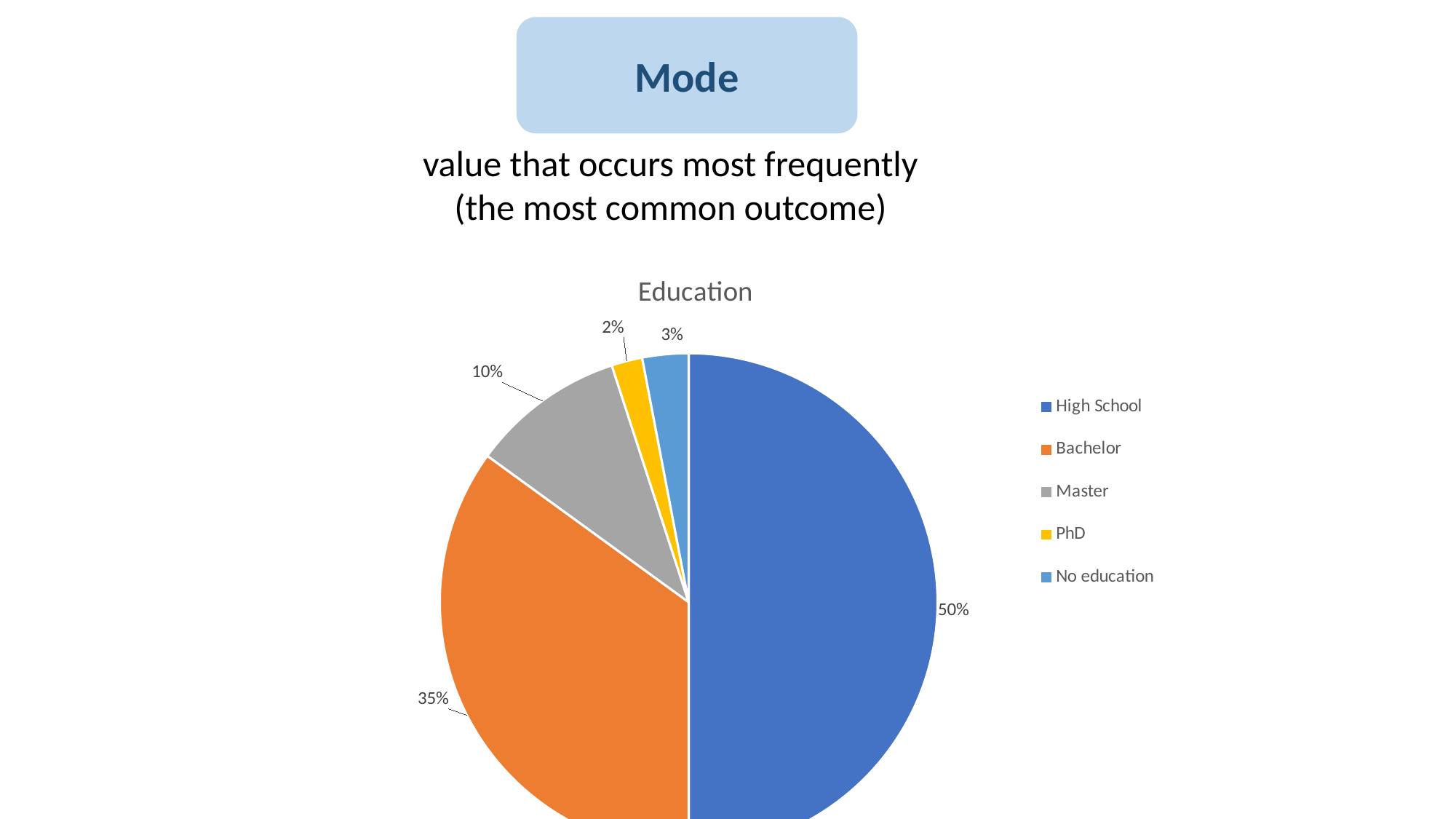
How many categories does the legend list? 5 Which category has the largest slice? High School What is the difference between the High School and Bachelor shares? 15% What type of chart is shown on the slide? pie chart What is the title of the chart? Education What is the value for PhD? 2% What is the value for No education? 3% What share of the pie does High School have? 50% Which category has the smallest slice? PhD What is the value for Master? 10% What is the value for Bachelor? 35% Which is larger, the share for Master or the share for No education? Master